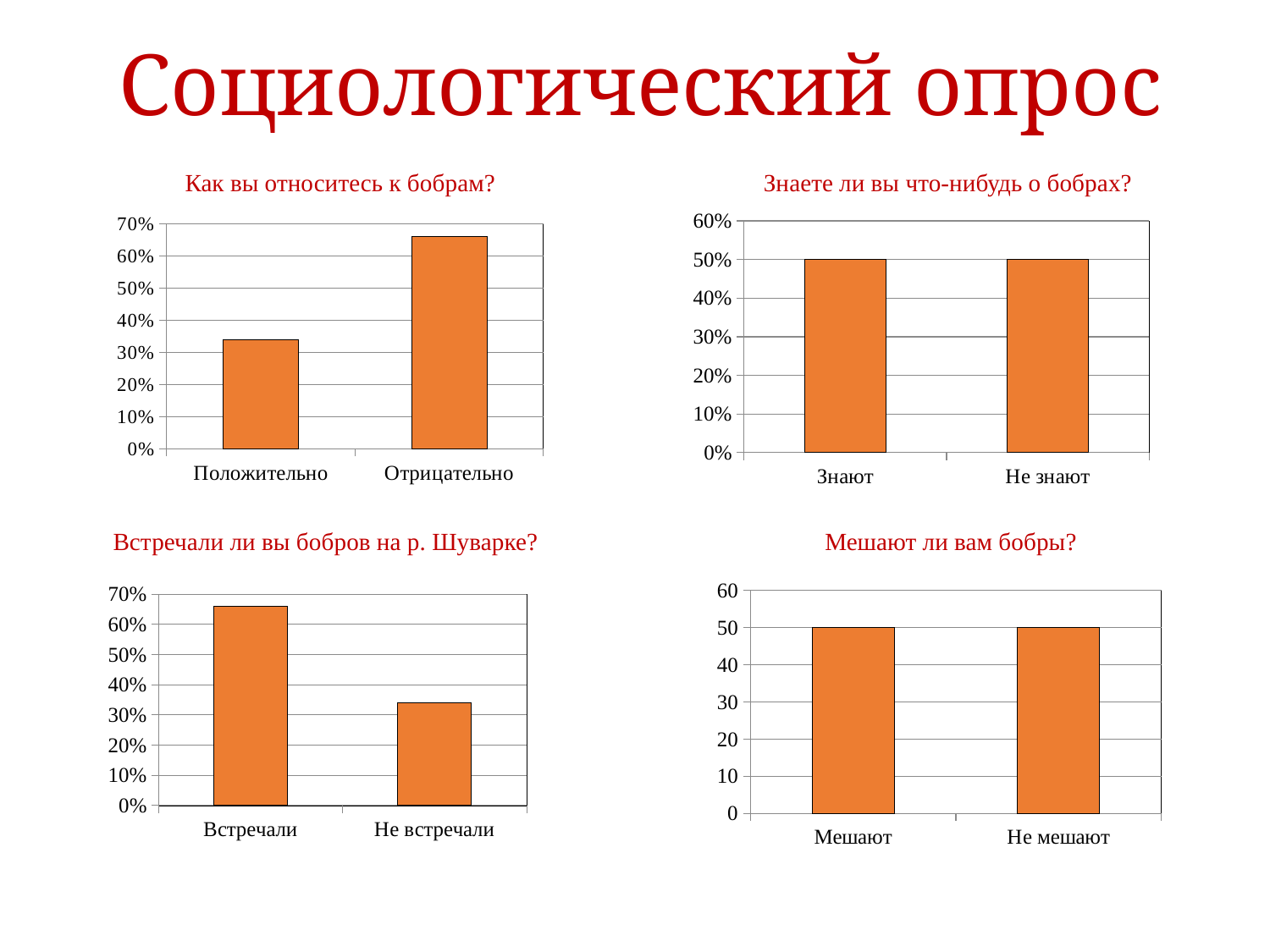
In the chart titled "Как вы относитесь к бобрам?", is the value for Отрицательно greater or less than 60%? greater What kind of chart is the one titled "Мешают ли вам бобры?"? bar chart In the chart titled "Знаете ли вы что-нибудь о бобрах?", how many categories are shown on the x axis? 2 In the chart titled "Как вы относитесь к бобрам?", is the value for Положительно greater or less than 40%? less In the chart titled "Знаете ли вы что-нибудь о бобрах?", what is the value for Не знают? 50% In the chart titled "Как вы относитесь к бобрам?", which category has the highest value? Отрицательно In the chart titled "Встречали ли вы бобров на р. Шуварке?", is the value for Встречали greater or less than 60%? greater In the chart titled "Встречали ли вы бобров на р. Шуварке?", which is larger, Встречали or Не встречали? Встречали In the chart titled "Мешают ли вам бобры?", what is the difference between Мешают and Не мешают? 0 In the chart titled "Знаете ли вы что-нибудь о бобрах?", what is the value for Знают? 50% In the chart titled "Встречали ли вы бобров на р. Шуварке?", which category has the lowest value? Не встречали In the chart titled "Мешают ли вам бобры?", what is the value for Мешают? 50